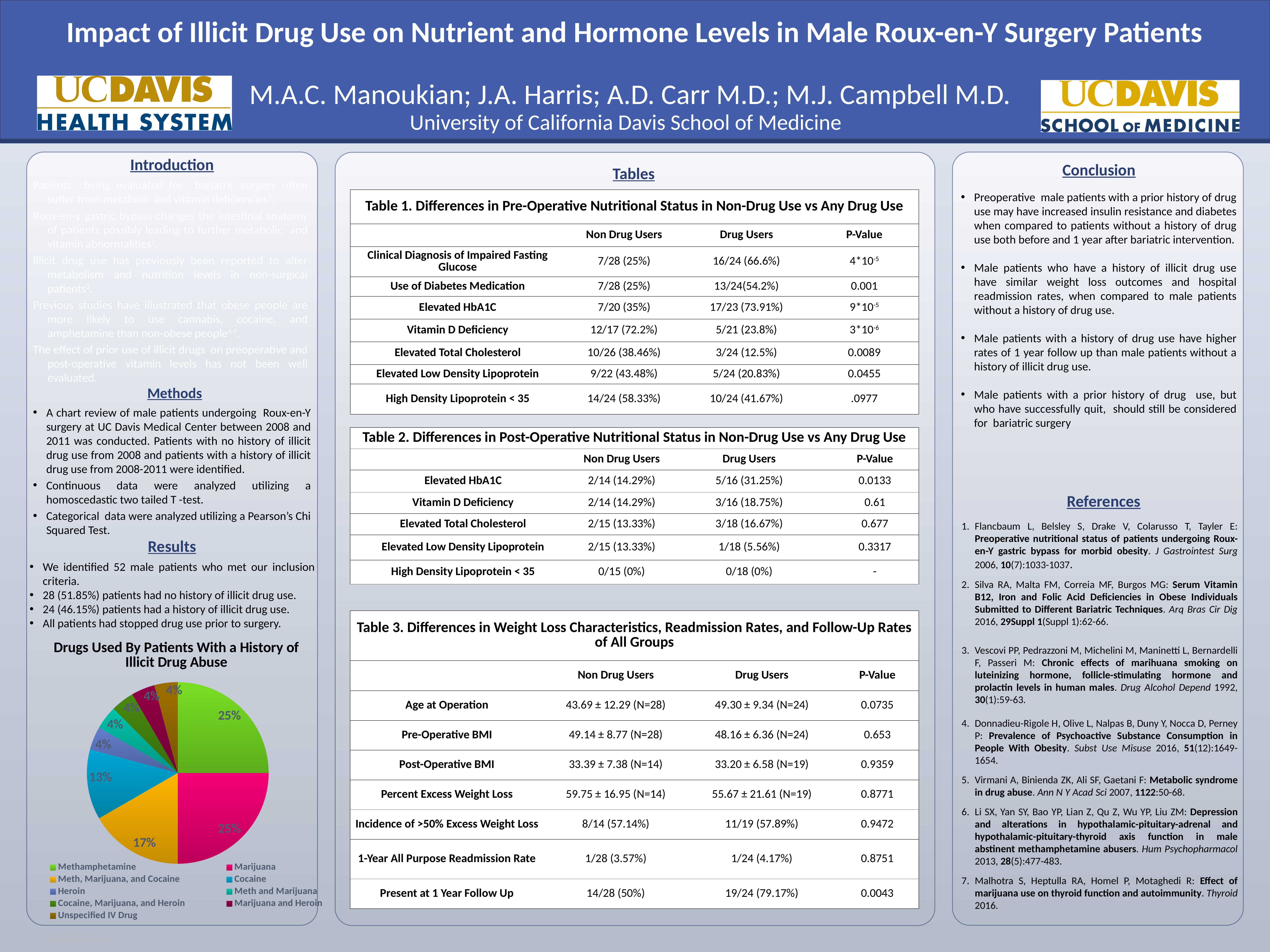
In the pie chart, what share of patients used an Unspecified IV Drug? 4% In the pie chart, what is the difference between the share for Methamphetamine and the share for Cocaine? 12% What type of chart is shown under the heading "Drugs Used By Patients With a History of Illicit Drug Abuse"? Pie chart In the pie chart, what share of patients used Methamphetamine? 25% In the pie chart, what share of patients used Heroin? 4% In the pie chart, what share of patients used Marijuana? 25% In the pie chart, what share of patients used Cocaine? 13% In the pie chart, which is larger: the share for Cocaine or the share for Meth, Marijuana, and Cocaine? Meth, Marijuana, and Cocaine In the pie chart, what is the difference between the share for Meth, Marijuana, and Cocaine and the share for Heroin? 13% How many drug categories does the pie chart's legend list? 9 In the pie chart, what share of patients used Meth, Marijuana, and Cocaine? 17% What is the title of the pie chart on the slide? Drugs Used By Patients With a History of Illicit Drug Abuse